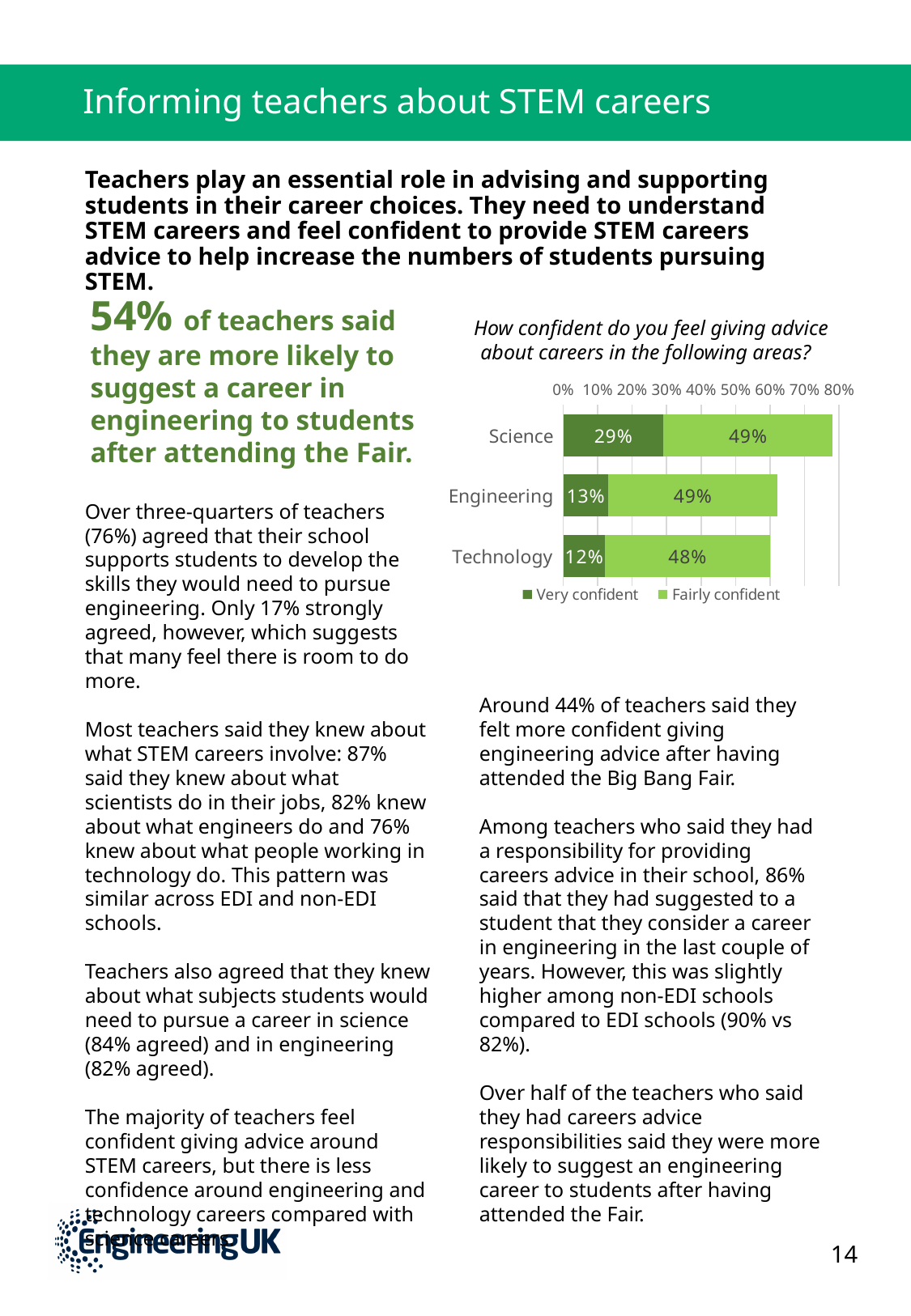
What percentage of teachers are very confident giving advice about careers in Science? 29% What is the combined percentage of teachers who are very or fairly confident giving advice about careers in Technology? 60% How many series does the chart legend list? 2 Which area has the highest share of teachers who are very confident? Science What percentage of teachers are very confident giving advice about careers in Engineering? 13% What is the difference between the very confident percentages for Science and Engineering? 16% Which area has the lowest share of teachers who are very confident? Technology What is the combined percentage of teachers who are very or fairly confident giving advice about careers in Science? 78% What kind of chart is shown on the slide? Stacked bar chart What percentage of teachers are fairly confident giving advice about careers in Technology? 48% Is the very confident percentage for Science larger or smaller than the very confident percentage for Technology? Larger How many career areas are shown in the chart? 3